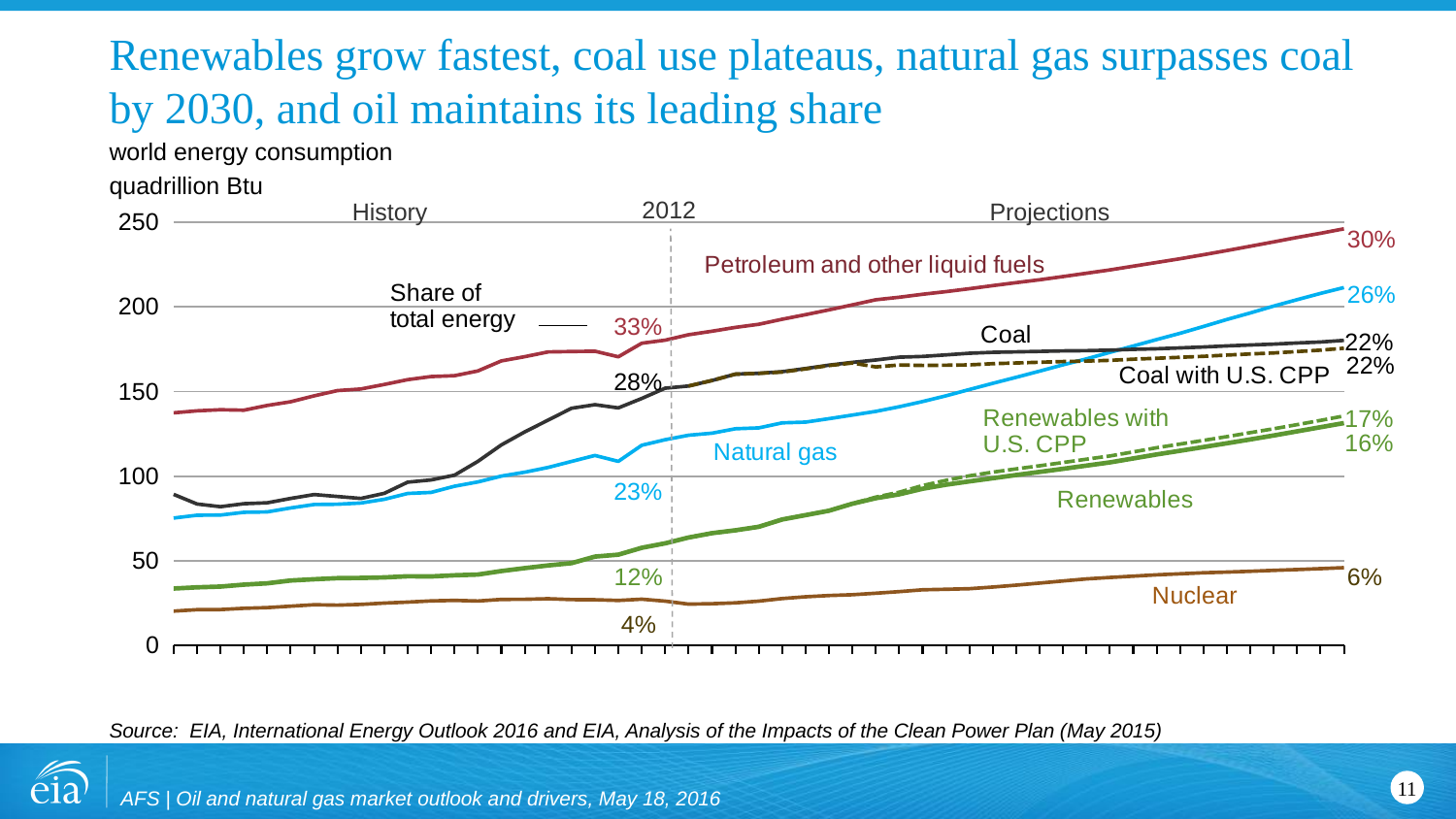
What kind of chart is shown on the slide? line chart What share of total energy is labelled for coal in 2012? 28% What unit is used for the values on the vertical axis? quadrillion Btu Is the consumption of petroleum and other liquid fuels at the end of the projection period greater or less than 200 quadrillion Btu? greater Is nuclear consumption at the end of the projection period greater or less than 50 quadrillion Btu? less What share of total energy does petroleum and other liquid fuels have in 2012, as labelled on the chart? 33% What share of total energy is labelled for renewables with U.S. CPP at the end of the projection period? 17% Does natural gas consumption rise or fall over the projection period? rise What share of total energy is labelled for nuclear at the end of the projection period? 6% Which fuel has the lowest consumption throughout the chart? Nuclear What share of total energy is labelled for natural gas in 2012? 23% Which fuel has the highest consumption at the end of the projection period? Petroleum and other liquid fuels